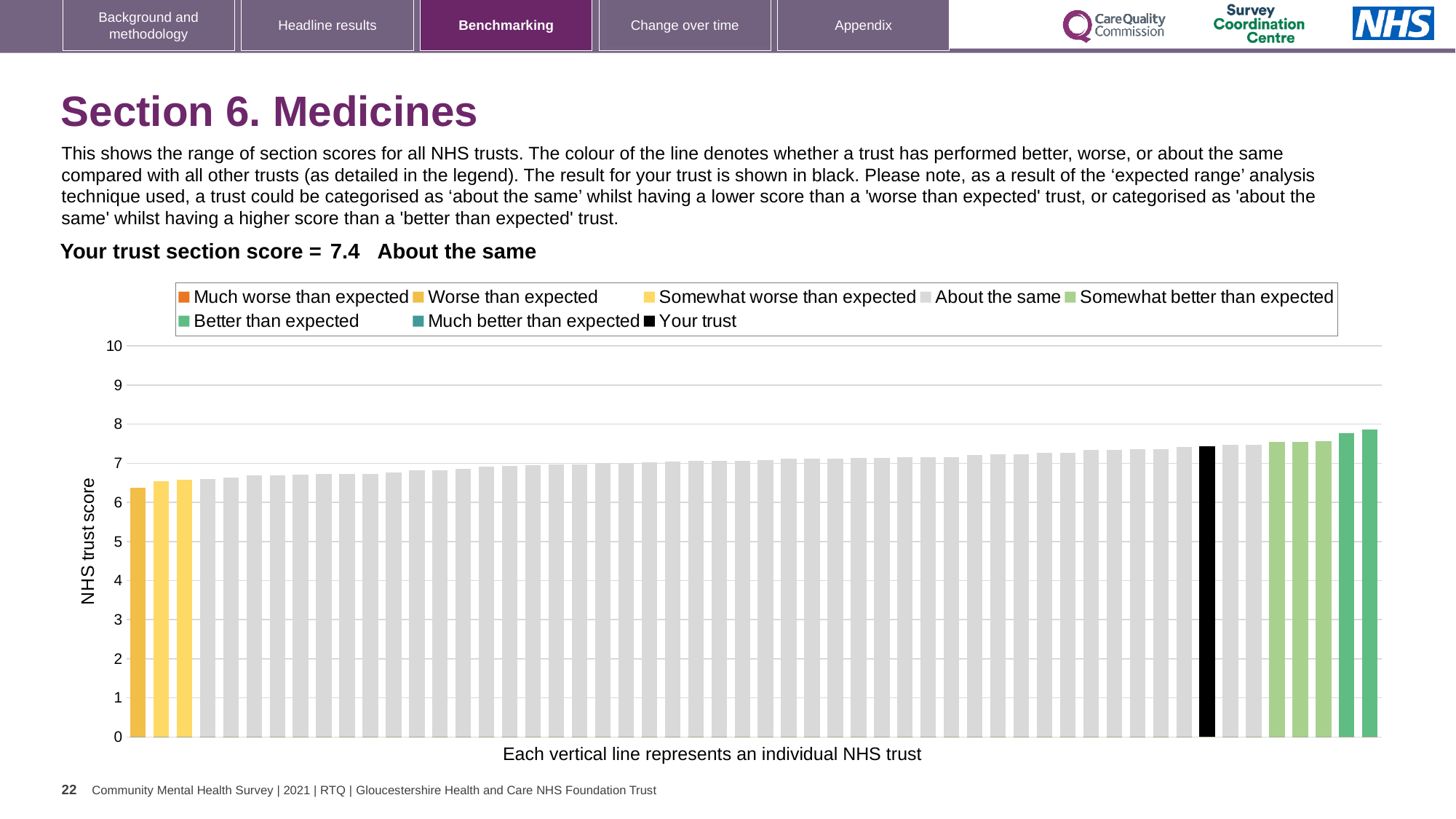
Do the bar values rise or fall from left to right along the x axis? Rise What is the section score for 'Your trust' shown on the slide? 7.4 What is the label on the vertical axis of the chart? NHS trust score Is the value of the black 'Your trust' bar greater or less than 7? greater What kind of chart is used to show the range of section scores? Bar chart How many entries does the chart legend list? 8 Which legend category does the lowest bar on the chart belong to? Worse than expected Which performance category is 'Your trust' assigned to for Section 6. Medicines? About the same Is the value of the lowest bar greater or less than 6? greater Is the value of the highest bar greater or less than 8? less Which legend category does the highest bar on the chart belong to? Better than expected